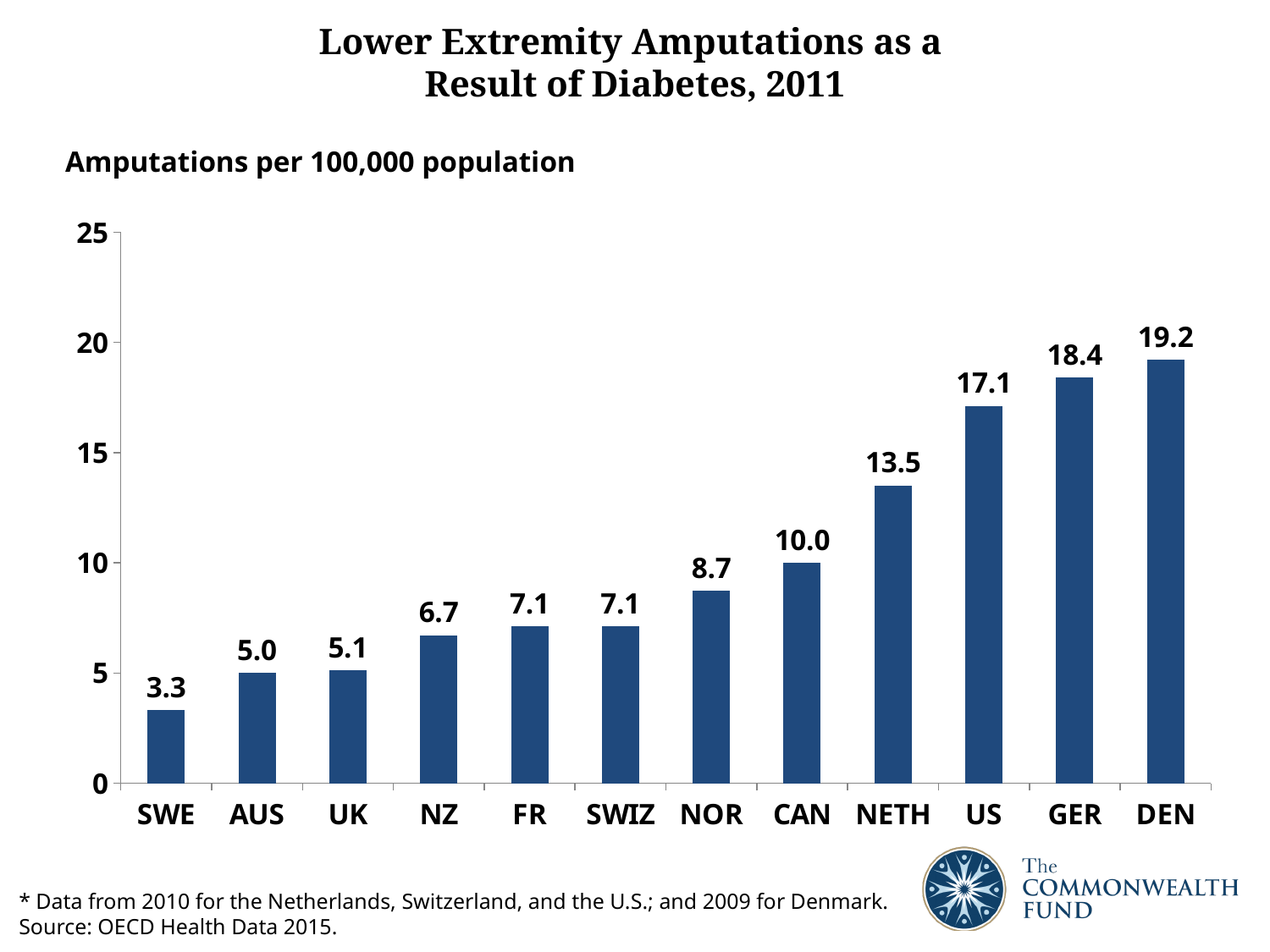
How many countries are shown on the chart? 12 Is the value for NOR greater or less than 10? less What kind of chart is shown on the slide? bar chart What unit is given for the values on the chart? Amputations per 100,000 population Which country has the lowest amputation rate? SWE Which country has the highest amputation rate? DEN What is the difference between the values for DEN and GER? 0.8 What is the difference between the values for US and SWE? 13.8 Which is larger, the value for NETH or the value for CAN? NETH What is the value for NZ? 6.7 Do the values rise or fall from left to right along the x axis? rise What is the value for the US? 17.1